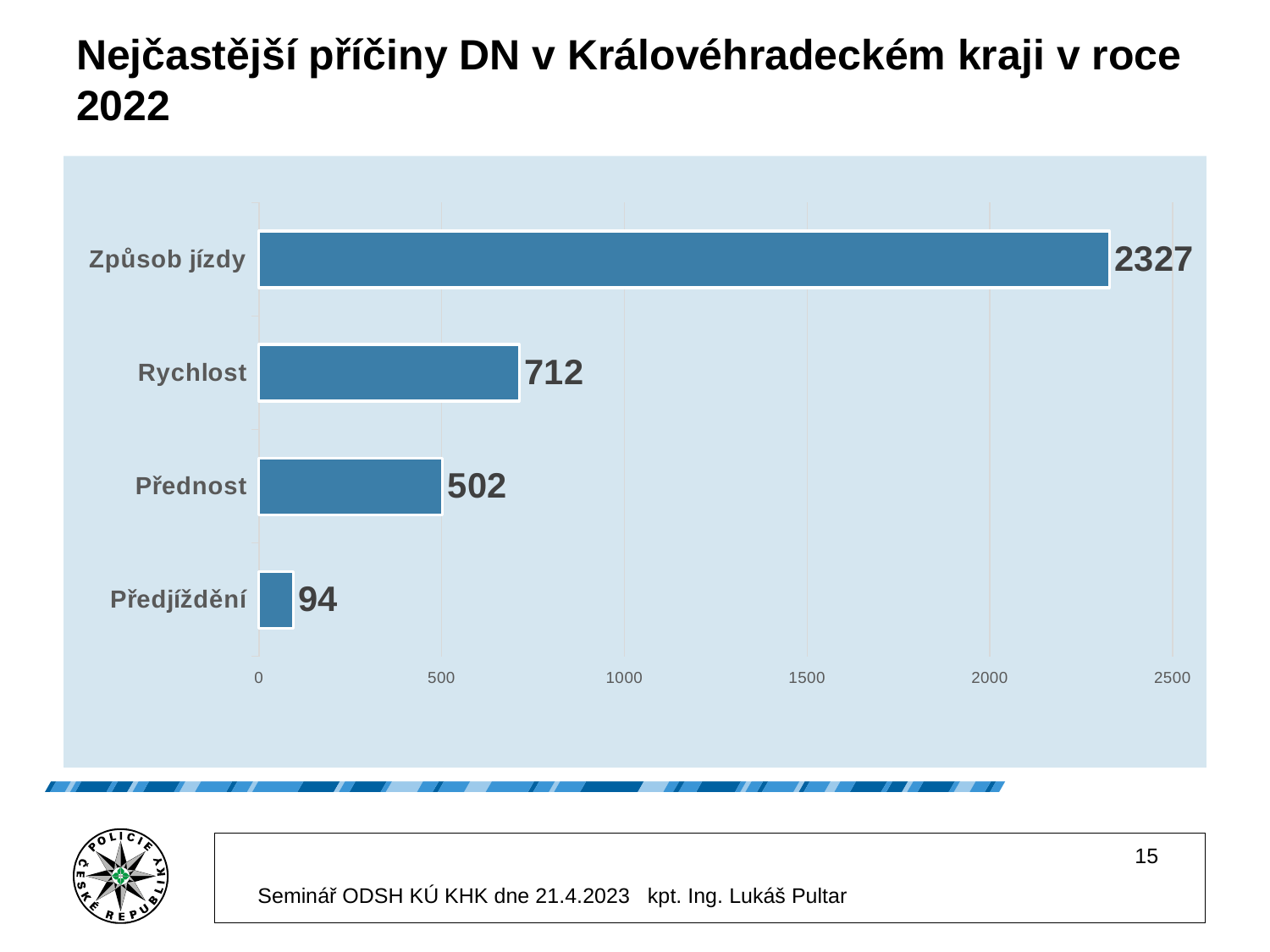
What is the value for Přednost? 502 What is the value for Předjíždění? 94 What is the difference between the values for Rychlost and Přednost? 210 What is the difference between the values for Způsob jízdy and Rychlost? 1615 What is the value for Způsob jízdy? 2327 Is the value for Rychlost greater or less than 500? greater Which is larger, the value for Přednost or the value for Předjíždění? Přednost What kind of chart is shown on the slide? bar chart Which category has the lowest value? Předjíždění Which category has the highest value? Způsob jízdy How many categories are shown in the chart? 4 What is the value for Rychlost? 712